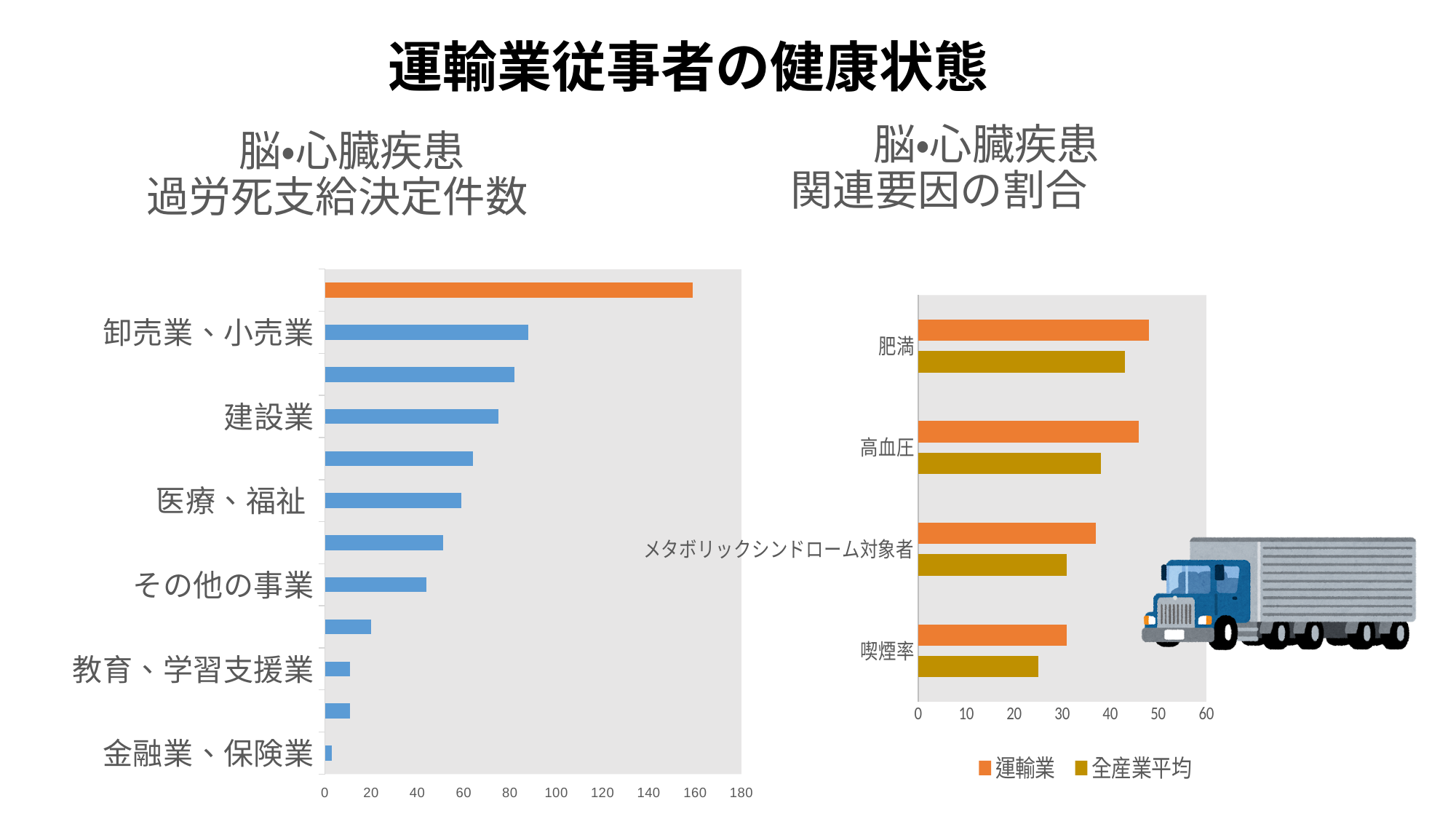
In the left chart (過労死支給決定件数), is the value for 教育、学習支援業 greater or less than 20? less In the left chart (過労死支給決定件数), do the bar values rise or fall going from the top bar to the bottom bar? fall In the left chart (過労死支給決定件数), is the value for 卸売業、小売業 greater or less than 60? greater In the left chart (過労死支給決定件数), is the value of the top orange bar greater or less than 140? greater How many series does the legend of the right chart (関連要因の割合) list? 2 In the right chart (関連要因の割合), which category has the lowest 全産業平均 value? 喫煙率 In the left chart (過労死支給決定件数), which of the labelled categories has the lowest value? 金融業、保険業 What type of chart is the left chart titled 脳•心臓疾患 過労死支給決定件数? bar chart How many categories are shown in the right chart (関連要因の割合)? 4 In the right chart (関連要因の割合), which is larger for 喫煙率: 運輸業 or 全産業平均? 運輸業